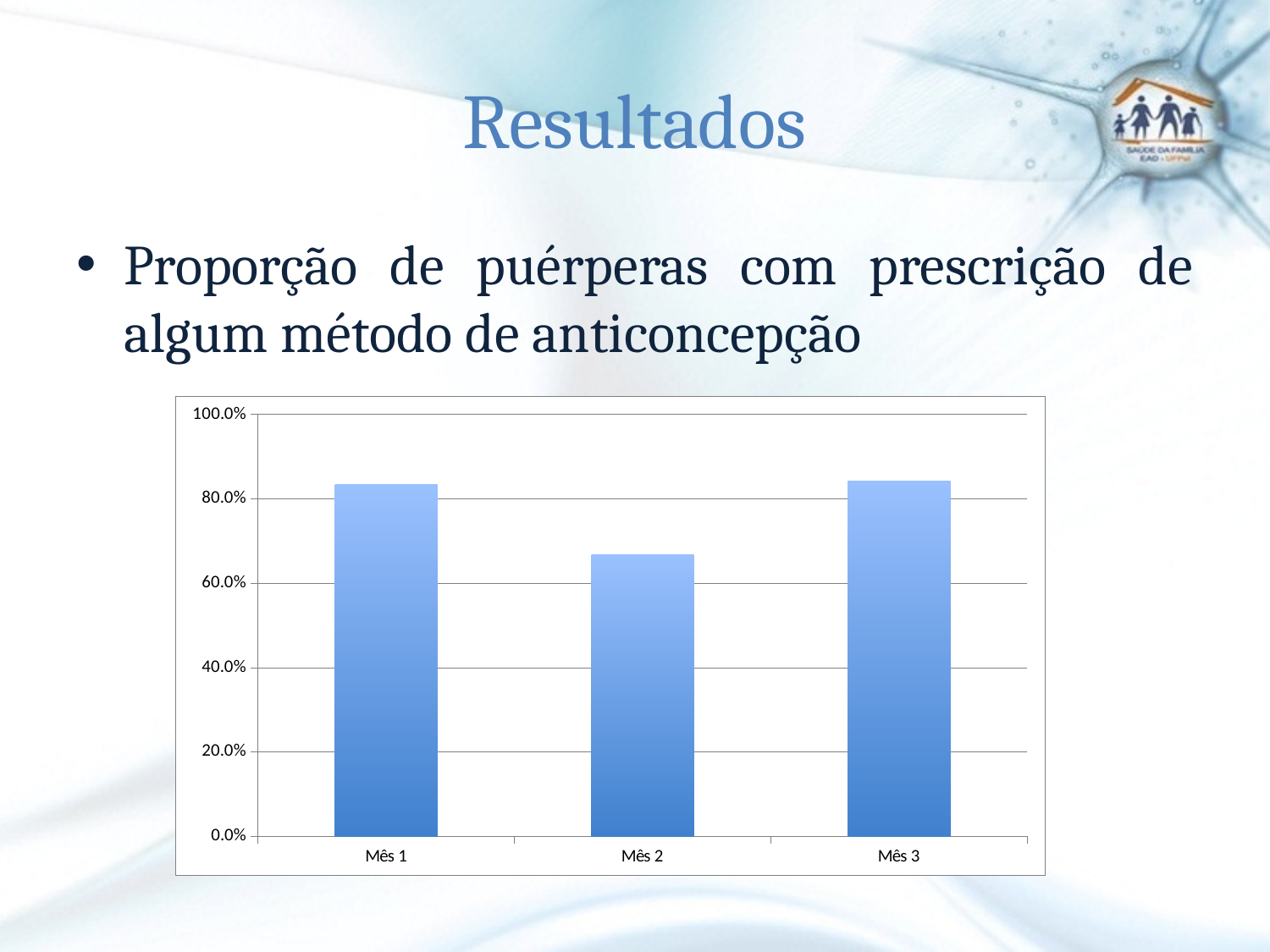
What is the highest value shown on the vertical axis of the chart? 100.0% Does the value rise or fall from Mês 1 to Mês 2? fall Which is larger, the value for Mês 2 or the value for Mês 3? Mês 3 What kind of chart is shown on the slide? bar chart Which month has the lowest value on the chart? Mês 2 Is the value for Mês 2 greater or less than 60.0%? greater Is the value for Mês 2 greater or less than 80.0%? less Is the value for Mês 3 greater or less than 100.0%? less How many categories (months) are plotted on the chart? 3 Which is larger, the value for Mês 1 or the value for Mês 2? Mês 1 What is the label of the first category on the horizontal axis? Mês 1